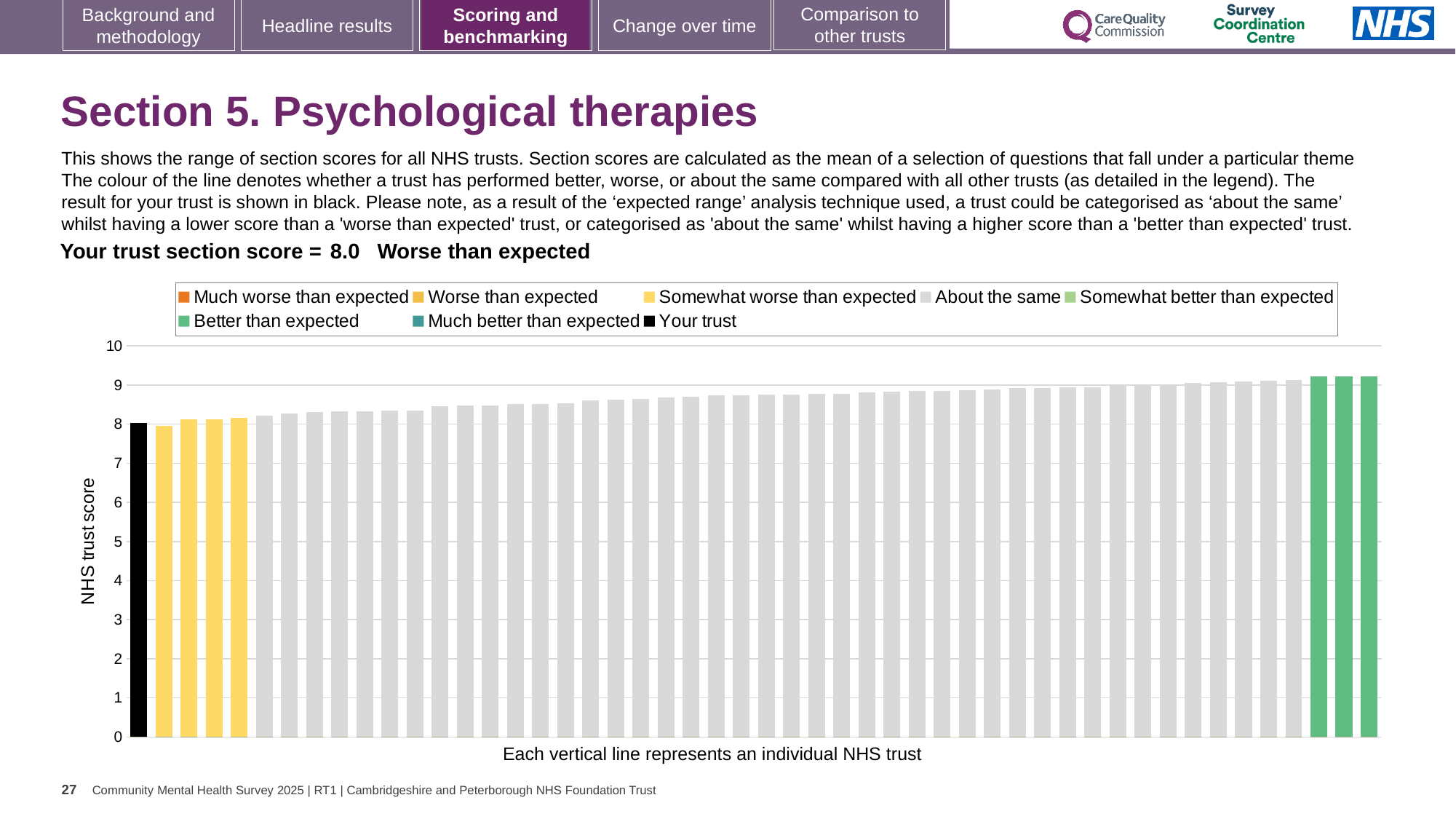
What is the label on the vertical axis of the chart? NHS trust score What colour is used for the 'Your trust' bar in the chart? black How many bars are coloured yellow (Somewhat worse than expected)? 4 Which is larger: the value of the black 'Your trust' bar or the value of the rightmost green bar? the rightmost green bar What kind of chart is shown on the slide? bar chart Are the values of the green 'Better than expected' bars at the right of the chart greater or less than 9? greater How many entries does the chart legend list? 8 What is your trust's section score for Psychological therapies? 8.0 Which category is your trust's section score placed in? Worse than expected Do the bar values rise or fall moving from left to right along the x axis? rise Is the value of the black 'Your trust' bar greater or less than 9? less How many bars are coloured green (Better than expected)? 3